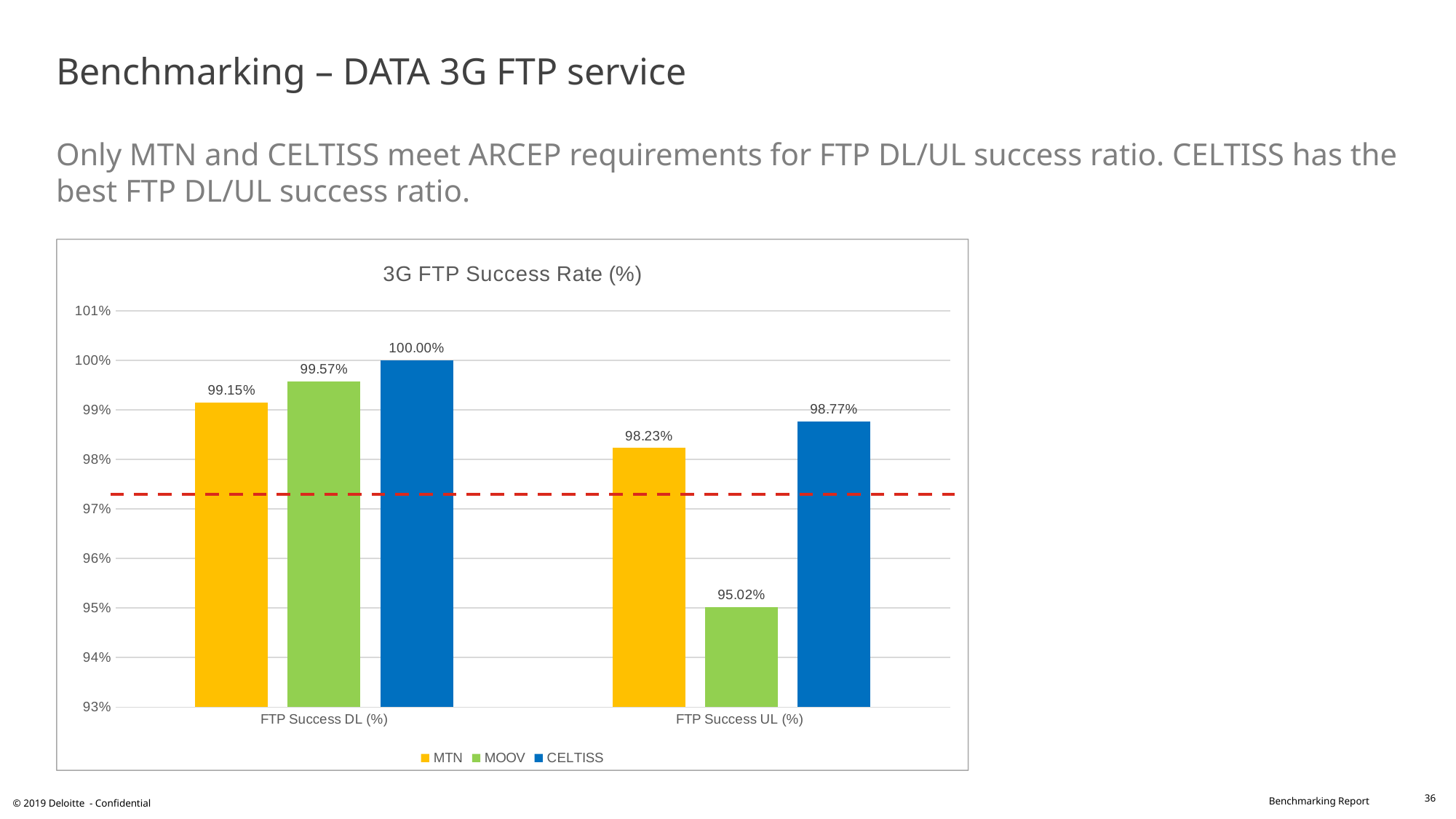
What kind of chart is shown on the slide? Bar chart What is the FTP Success DL (%) value for MTN? 99.15% Which operator has the lowest FTP Success UL (%)? MOOV What is the FTP Success UL (%) value for CELTISS? 98.77% What is the title of the chart? 3G FTP Success Rate (%) Which is larger: MOOV's FTP Success DL (%) or MTN's FTP Success DL (%)? MOOV's FTP Success DL (%) What is the FTP Success UL (%) value for MOOV? 95.02% How many categories are shown on the x axis? 2 Is MOOV's FTP Success UL (%) value greater or less than 97%? less How many series does the legend list? 3 Which operator has the highest FTP Success DL (%)? CELTISS What is the difference between CELTISS and MTN for FTP Success UL (%)? 0.54%